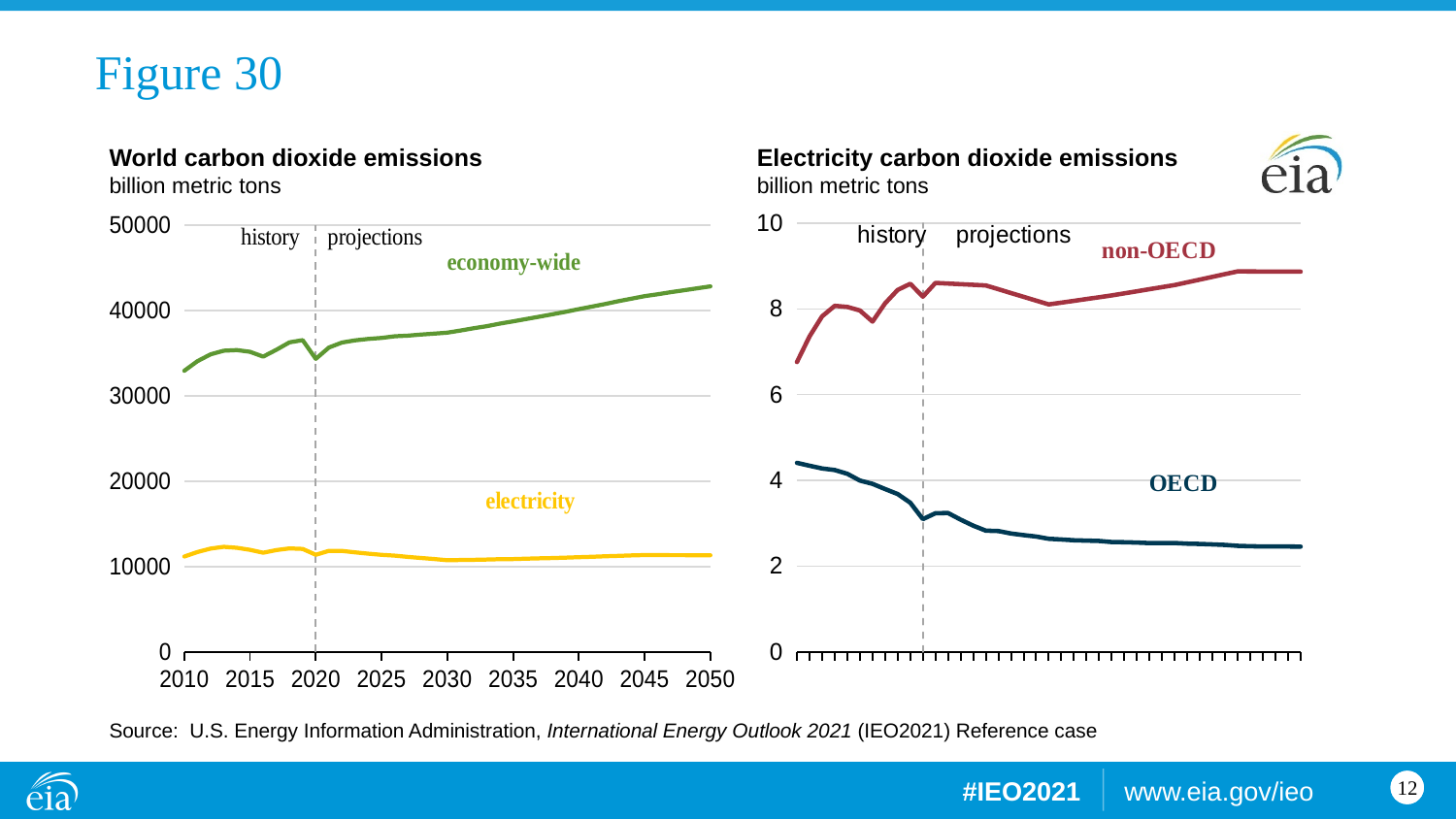
On the 'World carbon dioxide emissions' chart, is the economy-wide value in 2050 greater or less than 40000? greater On the 'Electricity carbon dioxide emissions' chart, which series is higher at the right end of the chart, non-OECD or OECD? non-OECD On the 'Electricity carbon dioxide emissions' chart, does the non-OECD series rise or fall over the period shown? rise How many series are plotted on the 'World carbon dioxide emissions' chart? 2 What kind of chart is the 'Electricity carbon dioxide emissions' chart? line chart On the 'World carbon dioxide emissions' chart, is the electricity value in 2050 greater or less than 20000? less On the 'Electricity carbon dioxide emissions' chart, is the OECD value at the right end of the chart greater or less than 4? less What kind of chart is the 'World carbon dioxide emissions' chart? line chart What unit is shown under the title of the 'World carbon dioxide emissions' chart? billion metric tons How many series are plotted on the 'Electricity carbon dioxide emissions' chart? 2 On the 'World carbon dioxide emissions' chart, does the economy-wide series rise or fall from 2020 to 2050? rise On the 'Electricity carbon dioxide emissions' chart, does the OECD series rise or fall over the period shown? fall